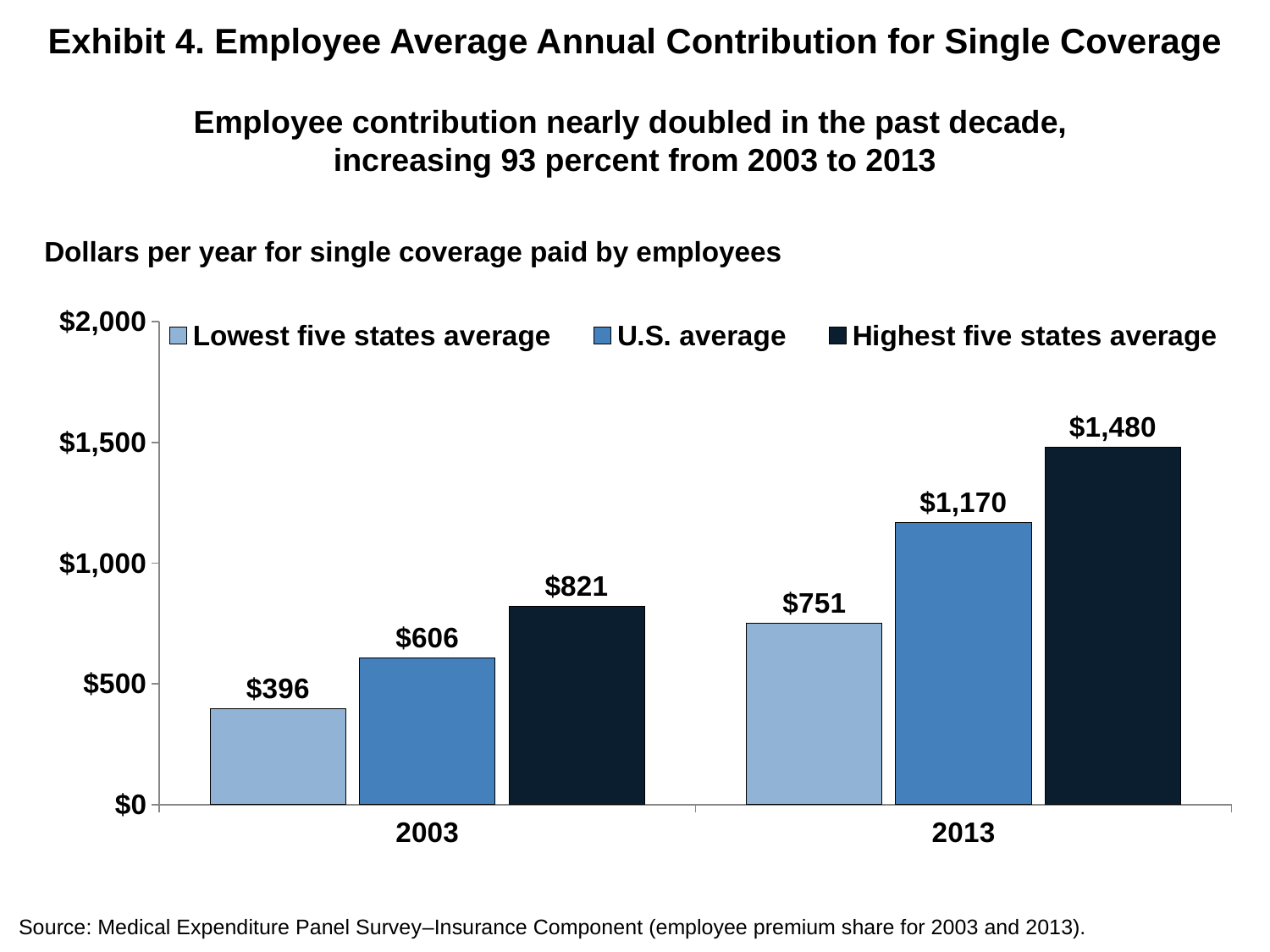
Which series has the highest value in 2013? Highest five states average Is the highest five states average in 2003 greater or less than $1,000? less What was the U.S. average employee contribution for single coverage in 2013? $1,170 Does the U.S. average employee contribution rise or fall from 2003 to 2013? Rise What was the lowest five states average employee contribution in 2003? $396 Which series has the lowest value in 2003? Lowest five states average Which is larger: the lowest five states average in 2013 or the U.S. average in 2003? Lowest five states average in 2013 What was the highest five states average employee contribution in 2013? $1,480 What kind of chart is shown on the slide? Bar chart How many series does the legend list? 3 What is the difference between the highest five states average and the lowest five states average in 2003? $425 What is the difference between the U.S. average in 2013 and the U.S. average in 2003? $564